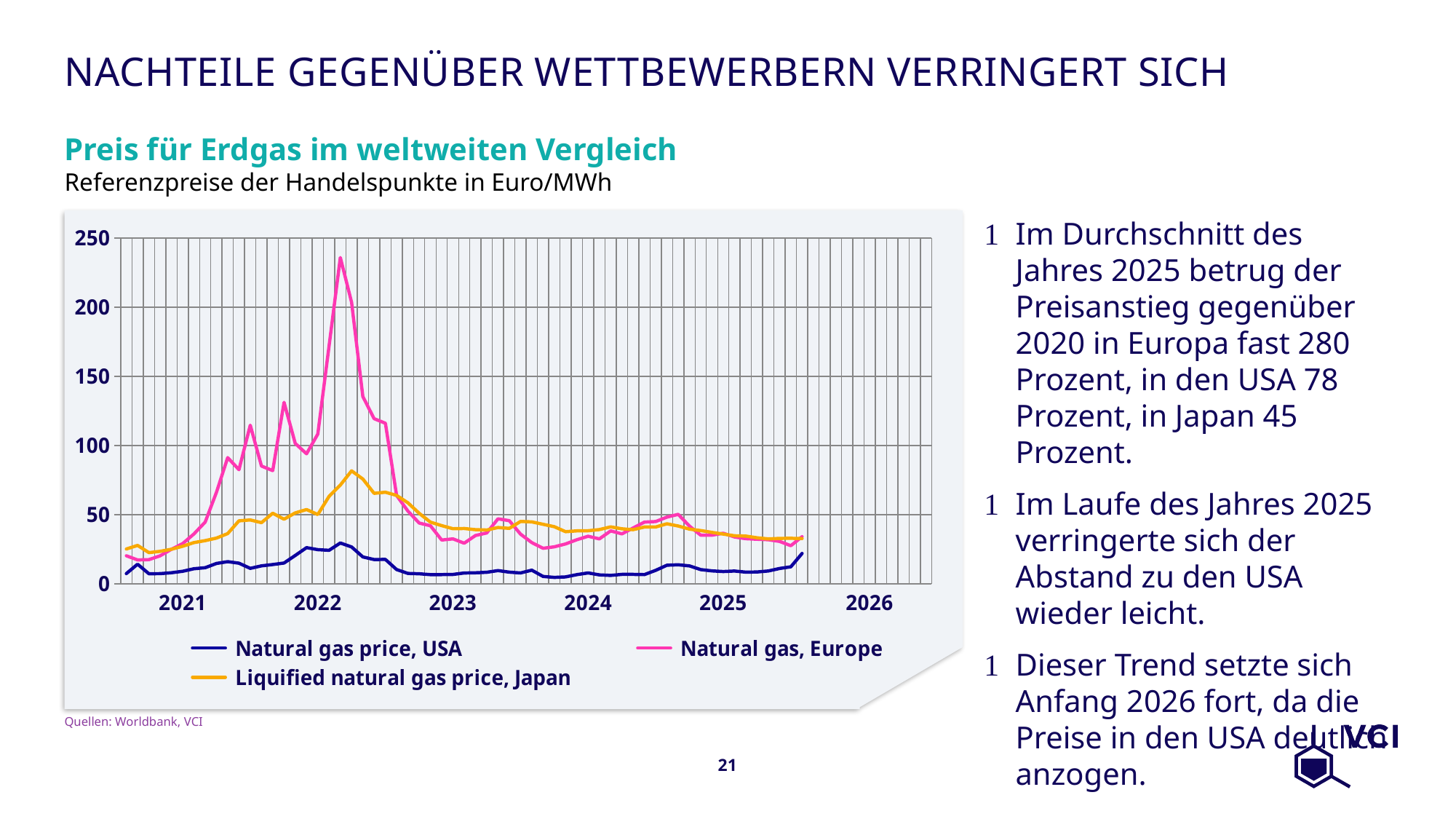
Does the Natural gas, Europe series rise or fall between its 2022 peak and 2023? fall Is the peak value of the Liquified natural gas price, Japan series greater or less than 100? less What is the title of the chart? Preis für Erdgas im weltweiten Vergleich In 2022, which series is higher: Natural gas, Europe or Natural gas price, USA? Natural gas, Europe What kind of chart is shown on the slide? line chart What unit are the values on the chart given in, according to the subtitle? Euro/MWh How many series does the chart legend list? 3 Is the peak value of the Natural gas, Europe series greater or less than 200? greater Is the highest value of the Natural gas price, USA series greater or less than 50? less Which series stays lowest across the whole period shown? Natural gas price, USA Which series reaches the highest value on the chart? Natural gas, Europe